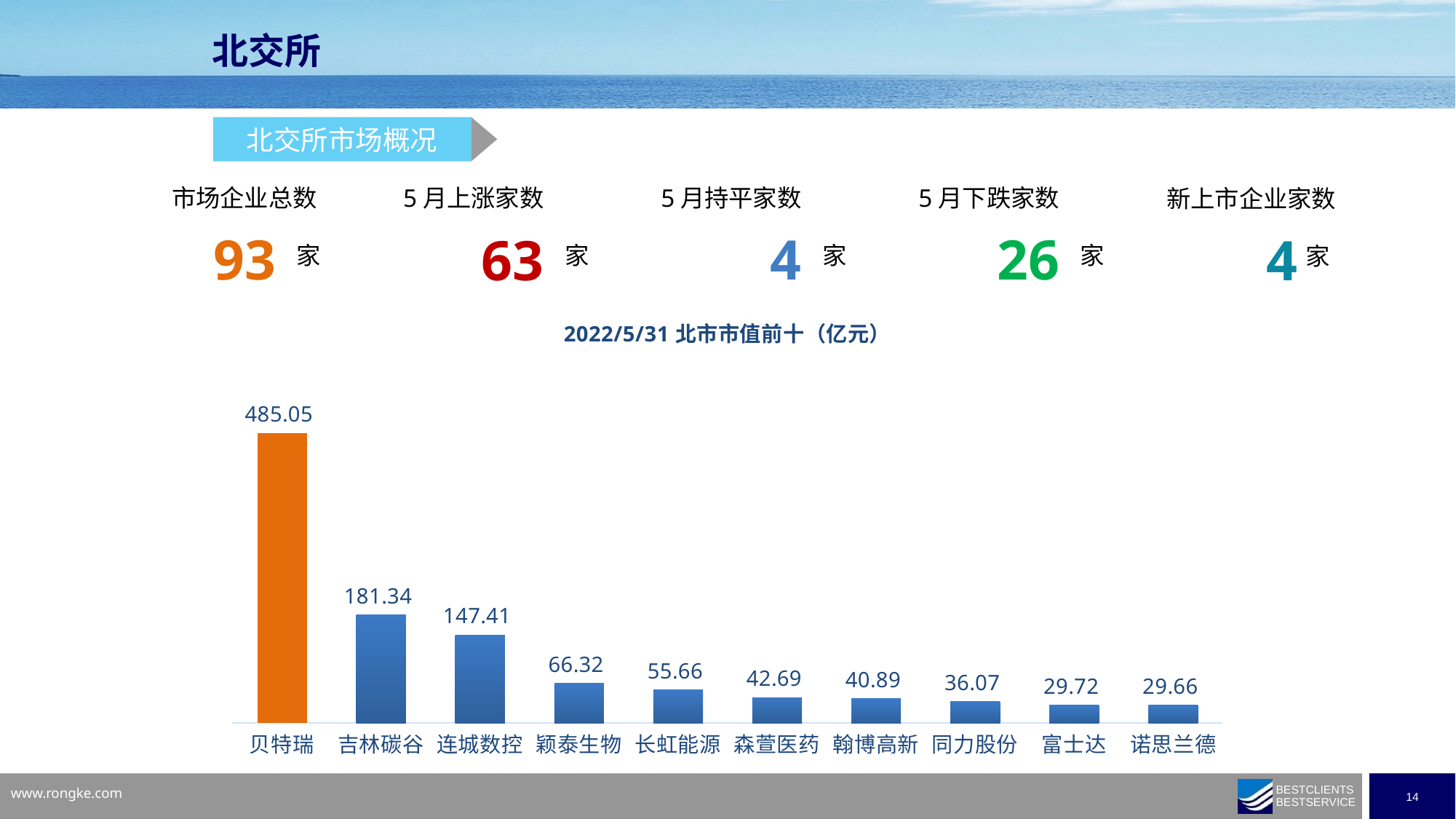
What kind of chart is shown on the slide? Bar chart What is the value shown for 长虹能源? 55.66 Do the values rise or fall from left to right across the chart? Fall What is the market value shown for 贝特瑞 in the chart? 485.05 What is the value shown for 连城数控? 147.41 Which is larger, the value for 吉林碳谷 or the value for 颖泰生物? 吉林碳谷 What is the difference between the values for 贝特瑞 and 吉林碳谷? 303.71 Which company has the highest market value in the chart? 贝特瑞 What is the difference between the values for 颖泰生物 and 长虹能源? 10.66 Which company has the lowest market value in the chart? 诺思兰德 How many companies are shown in the chart? 10 What is the value shown for 同力股份? 36.07